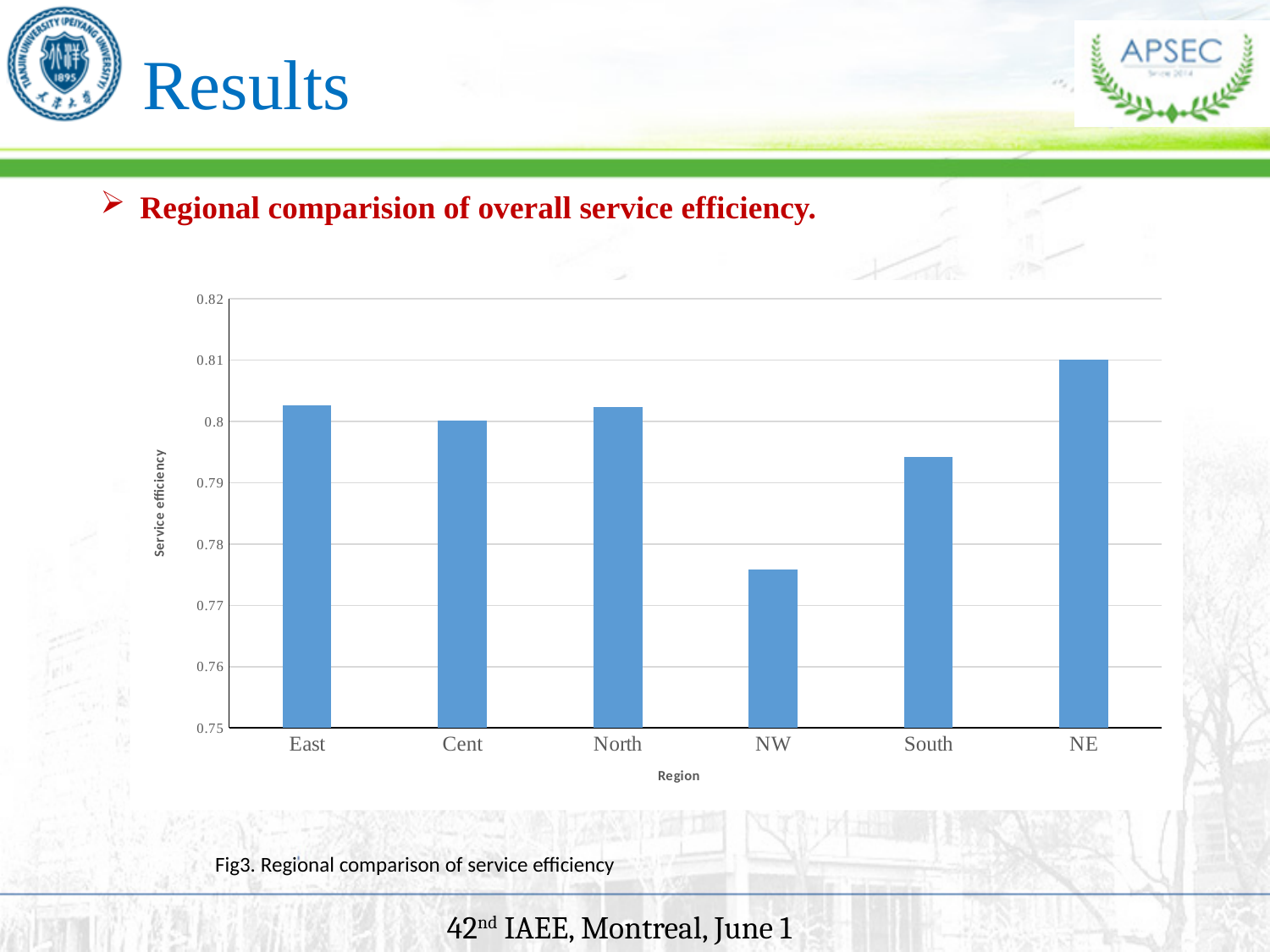
Which region has a higher service efficiency, NE or NW? NE Is the service efficiency for NE greater or less than 0.8? greater What is the label of the vertical axis of the chart? Service efficiency Is the service efficiency for NW greater or less than 0.78? less What kind of chart is shown on the slide? bar chart Which region has the highest service efficiency in the chart? NE How many regions are plotted on the x axis of the chart? 6 Is the service efficiency for South greater or less than 0.8? less What is the label of the horizontal axis of the chart? Region Which region has a higher service efficiency, South or NW? South Which region has the lowest service efficiency in the chart? NW